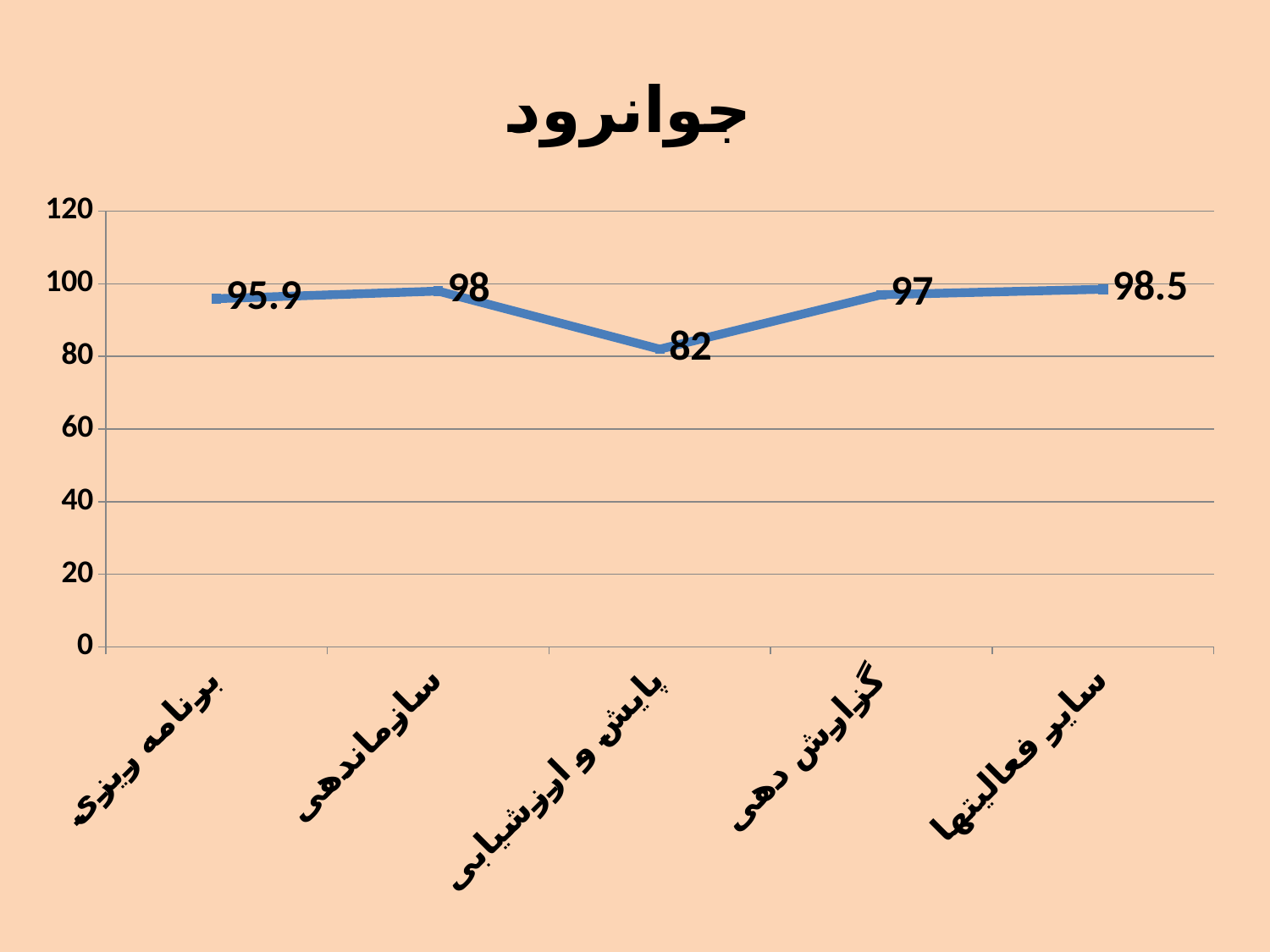
What is the value for گزارش دهی? 97 What is the difference between the values for سازماندهی and پایش و ارزشیابی? 16 How many categories are shown on the x axis? 5 What is the value for پایش و ارزشیابی? 82 What kind of chart is shown on the slide? line chart What is the value for سایر فعالیتها? 98.5 Which category has the lowest value? پایش و ارزشیابی What is the title of the chart? جوانرود Which is larger, the value for سازماندهی or the value for برنامه ریزی? سازماندهی Which category has the highest value? سایر فعالیتها Is the value for پایش و ارزشیابی greater or less than 100? less What is the value for برنامه ریزی? 95.9